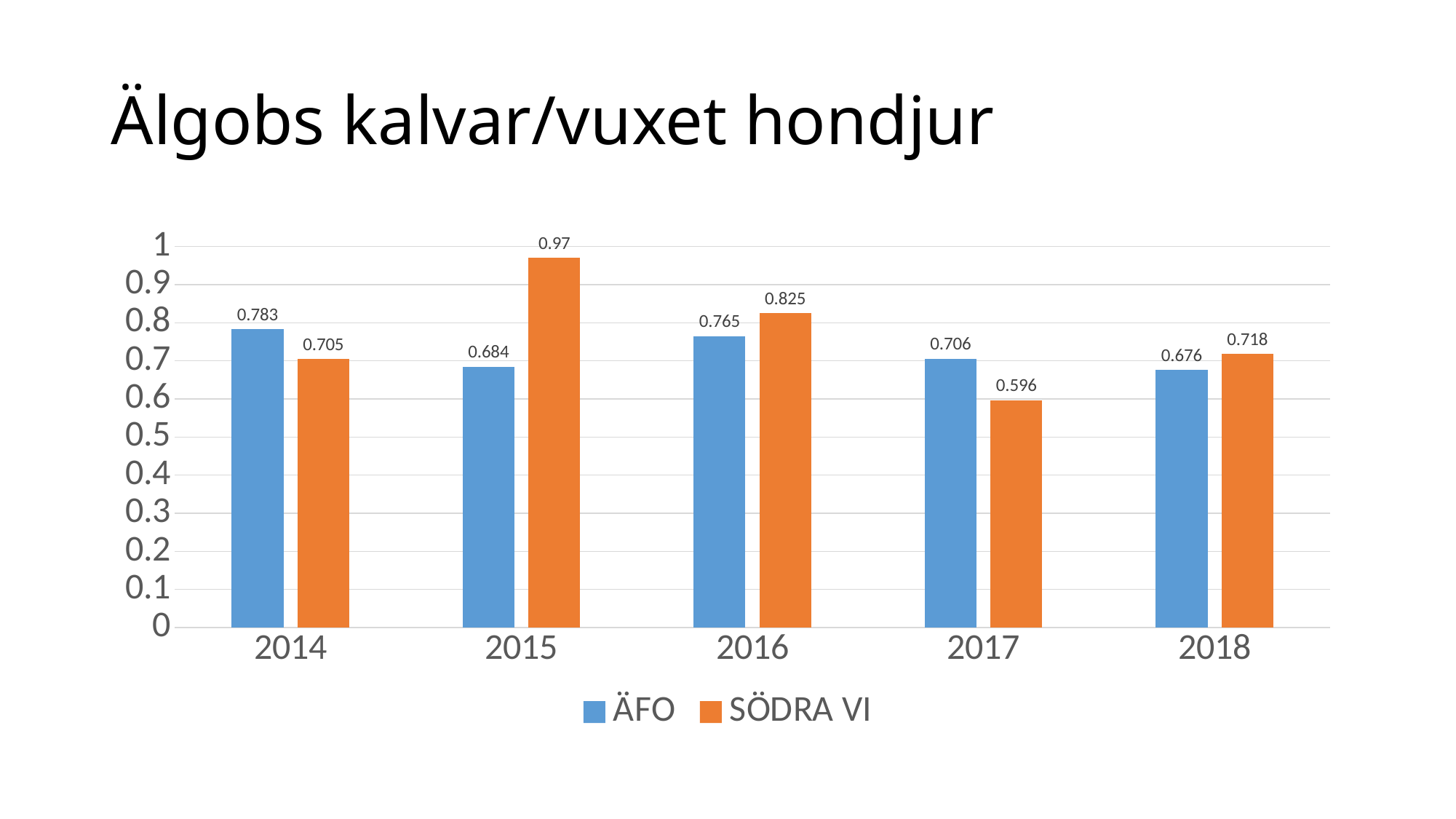
What kind of chart is shown on the slide? Bar chart Which series has the larger value in 2017, ÄFO or SÖDRA VI? ÄFO What is the value for SÖDRA VI in 2017? 0.596 In which year is the SÖDRA VI value highest? 2015 In which year is the ÄFO value lowest? 2018 How many series does the legend list? 2 What is the difference between the SÖDRA VI and ÄFO values in 2015? 0.286 What is the value for ÄFO in 2014? 0.783 What is the title of the chart? Älgobs kalvar/vuxet hondjur Is the value for SÖDRA VI in 2016 greater or less than 0.8? greater How many years are shown on the x axis? 5 What is the value for SÖDRA VI in 2015? 0.97